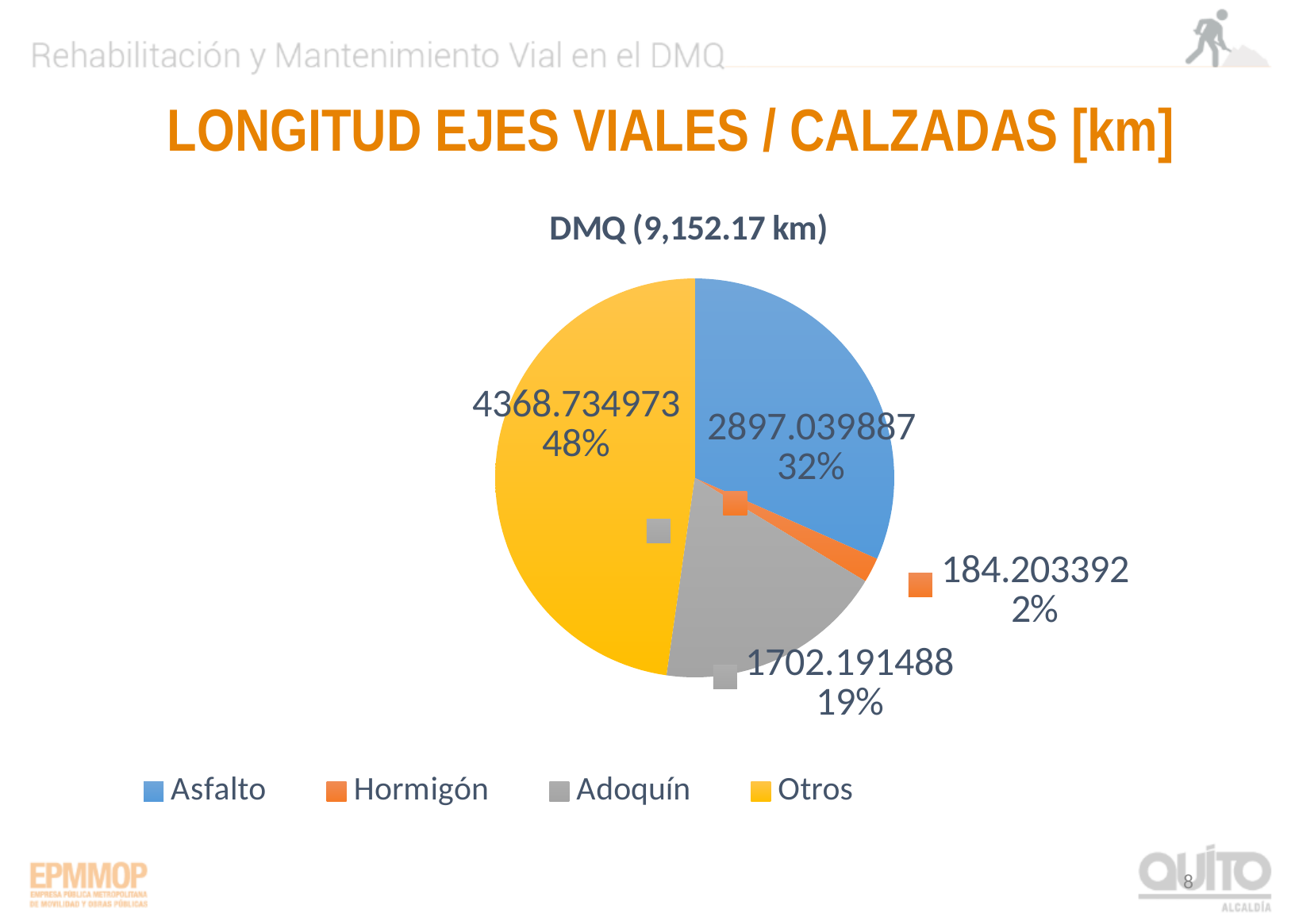
What is the chart's title? DMQ (9,152.17 km) What share of the pie does Adoquín represent? 19% Which category has the smallest slice? Hormigón Which is larger, Asfalto or Adoquín? Asfalto What is the value for Hormigón? 184.203392 What is the value for Adoquín? 1702.191488 What is the value for Asfalto? 2897.039887 What kind of chart is shown on the slide? pie chart How many categories does the legend list? 4 What is the value for Otros? 4368.734973 What share of the pie does Otros represent? 48% Which category has the largest slice? Otros